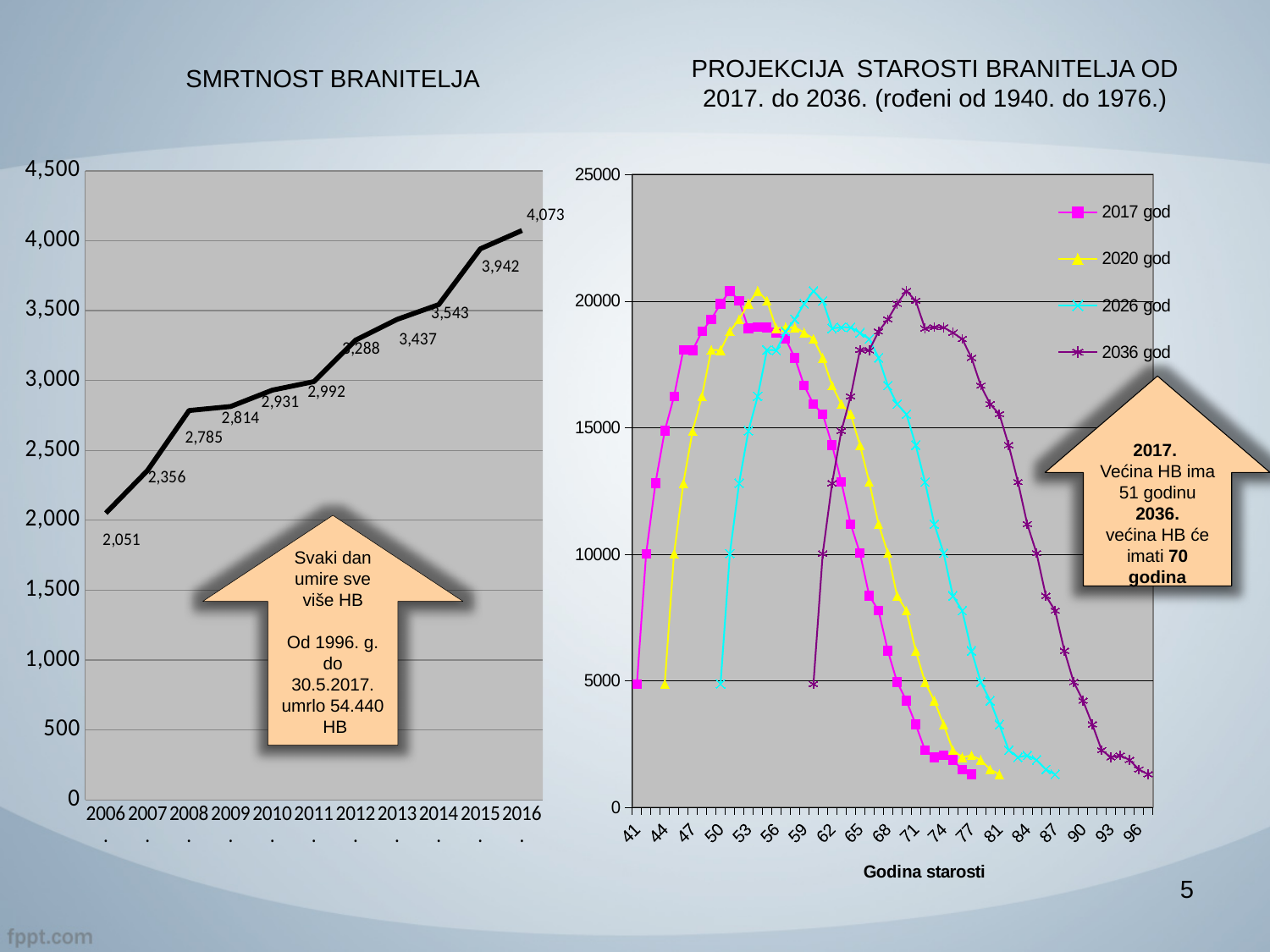
On the SMRTNOST BRANITELJA chart, what is the difference between the values for 2016 and 2015? 131 On the PROJEKCIJA STAROSTI BRANITELJA chart, how many series does the legend list? 4 On the SMRTNOST BRANITELJA chart, what is the value for 2016? 4,073 On the SMRTNOST BRANITELJA chart, what is the value for 2006? 2,051 On the PROJEKCIJA STAROSTI BRANITELJA chart, is the value of the 2017 god series at age 51 greater or less than 15000? greater On the SMRTNOST BRANITELJA chart, which year has the lowest value? 2006 On the SMRTNOST BRANITELJA chart, what is the value for 2012? 3,288 On the SMRTNOST BRANITELJA chart, do the values rise or fall from 2006 to 2016? rise On the SMRTNOST BRANITELJA chart, how many years are plotted? 11 On the SMRTNOST BRANITELJA chart, which year has the highest value? 2016 What kind of chart is the SMRTNOST BRANITELJA chart? line chart On the PROJEKCIJA STAROSTI BRANITELJA chart, what is the label of the x axis? Godina starosti